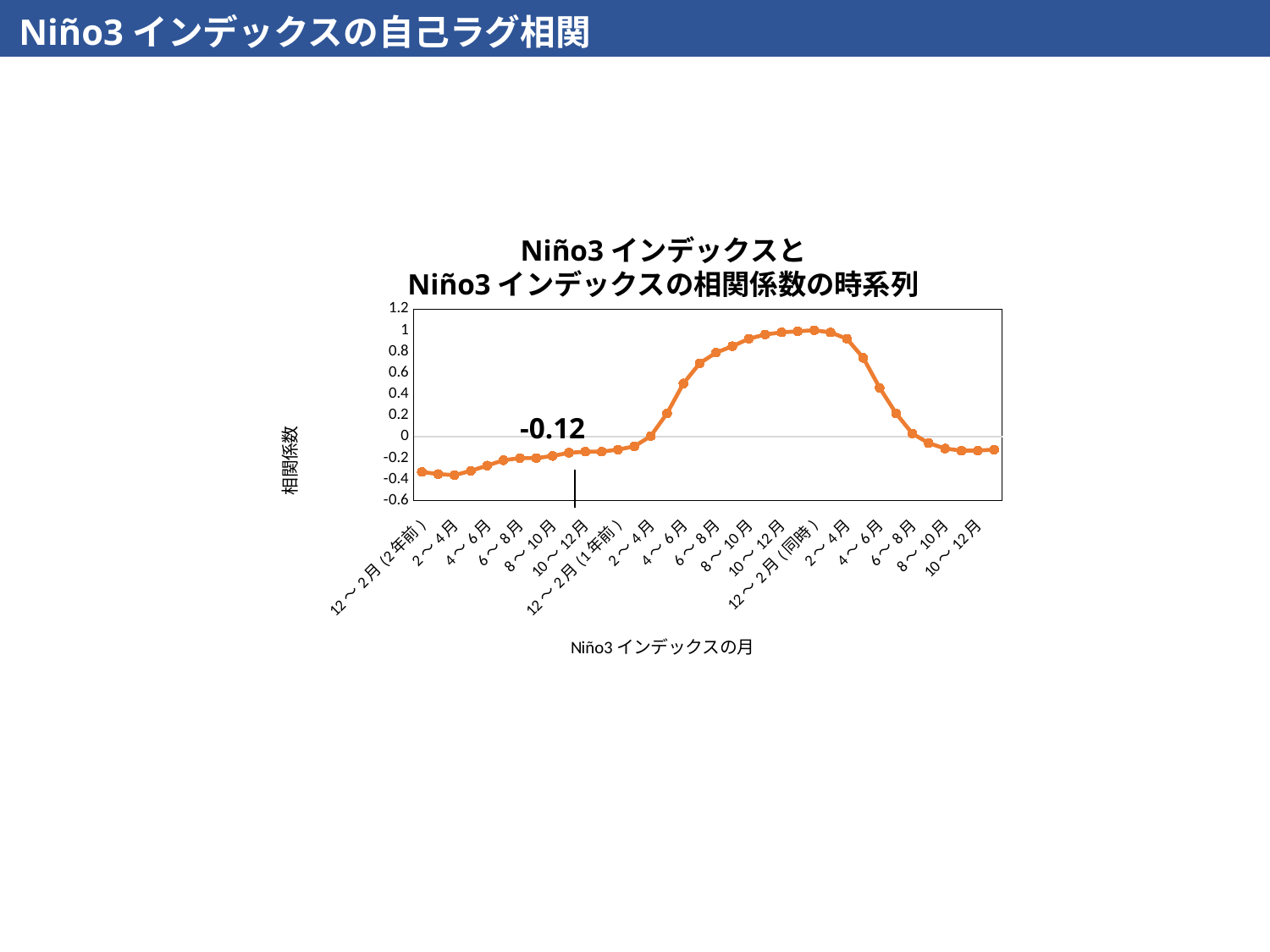
What is the label of the horizontal axis? Niño3 インデックスの月 At which month label does the correlation coefficient reach its highest value? 12～2月(同時) What is the correlation coefficient at 12～2月(1年前)? -0.12 What is the correlation coefficient at 12～2月(同時)? 1 Is the value at 12～2月(2年前) greater or less than -0.2? less What kind of chart is shown on the slide? line chart Which is larger, the value at 12～2月(同時) or the value at 12～2月(2年前)? 12～2月(同時) Is the value at the last 6～8月 on the x axis (after 同時) greater or less than 0.4? less From 12～2月(同時) to the final 10～12月 on the x axis, do the values rise or fall? fall What is the label of the vertical axis? 相関係数 Between 12～2月(1年前) and 12～2月(同時), do the values rise or fall? rise